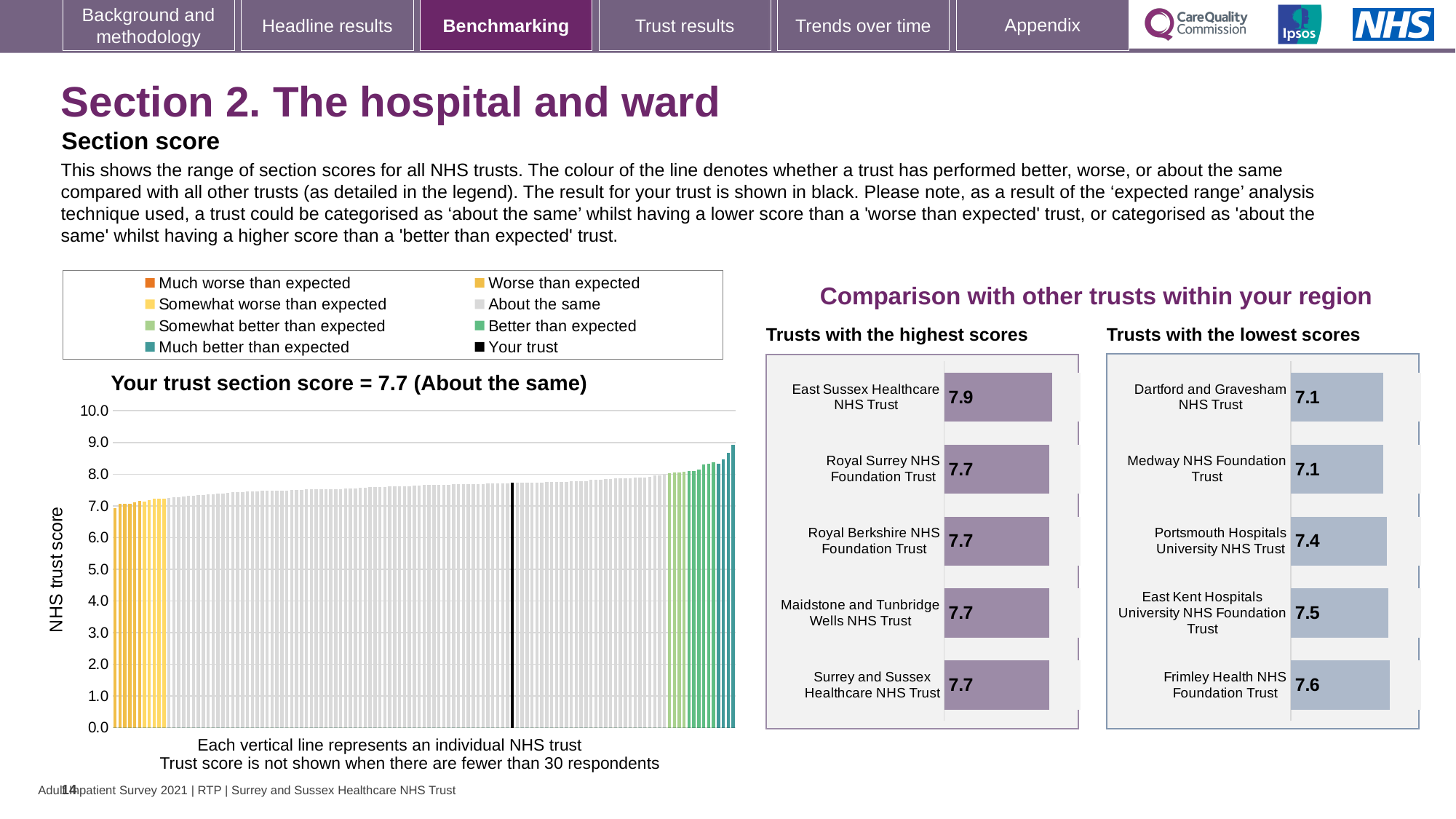
In the 'Trusts with the lowest scores' chart, what is the score for Dartford and Gravesham NHS Trust? 7.1 In the 'Trusts with the lowest scores' chart, what is the difference between the scores of Frimley Health NHS Foundation Trust and Dartford and Gravesham NHS Trust? 0.5 What kind of chart is the 'Trusts with the lowest scores' chart? Bar chart How many trusts are shown in the 'Trusts with the highest scores' chart? 5 In the 'Trusts with the lowest scores' chart, which trust has the highest score? Frimley Health NHS Foundation Trust In the 'Trusts with the highest scores' chart, what is the difference between the scores of East Sussex Healthcare NHS Trust and Surrey and Sussex Healthcare NHS Trust? 0.2 According to the title of the main chart on the left, what is your trust's section score? 7.7 In the main chart on the left, do the trust scores rise or fall from left to right? Rise In the 'Trusts with the lowest scores' chart, which has the larger score: Portsmouth Hospitals University NHS Trust or East Kent Hospitals University NHS Foundation Trust? East Kent Hospitals University NHS Foundation Trust How many entries does the legend above the main chart on the left list? 8 In the 'Trusts with the highest scores' chart, which trust has the highest score? East Sussex Healthcare NHS Trust In the 'Trusts with the highest scores' chart, what is the score for East Sussex Healthcare NHS Trust? 7.9